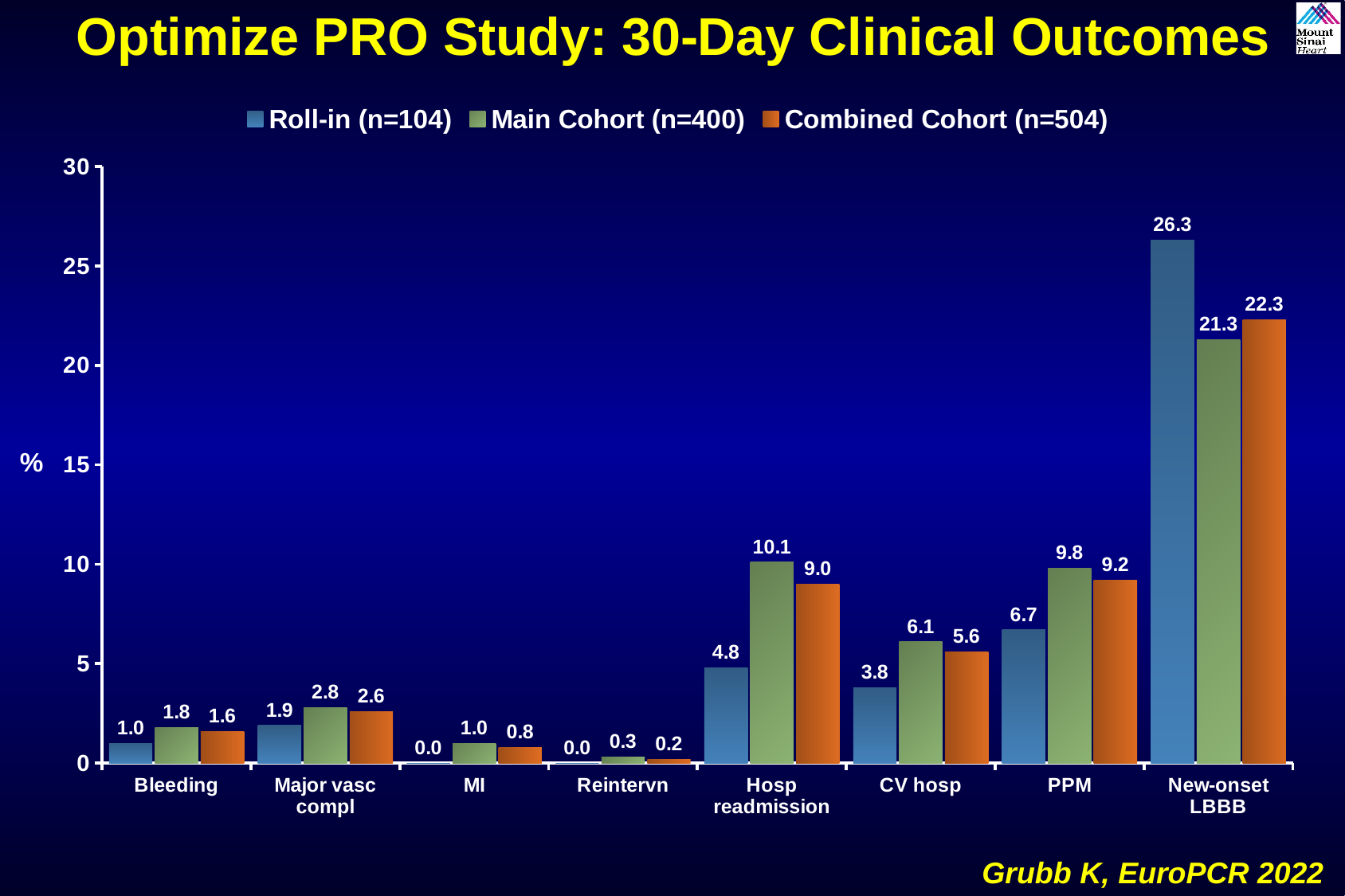
How many series does the legend list? 3 What kind of chart is shown on the slide? Bar chart What is the label on the y axis? % Which category has the lowest Main Cohort (n=400) value? Reintervn For CV hosp, which is larger: the Roll-in (n=104) value or the Main Cohort (n=400) value? Main Cohort (n=400) Which category has the highest Combined Cohort (n=504) value? New-onset LBBB What is the Roll-in (n=104) value for New-onset LBBB? 26.3 What is the difference between the Roll-in (n=104) and Main Cohort (n=400) values for New-onset LBBB? 5.0 How many outcome categories are shown on the x axis? 8 What is the Combined Cohort (n=504) value for PPM? 9.2 What is the Main Cohort (n=400) value for Hosp readmission? 10.1 Is the Main Cohort (n=400) value for PPM greater or less than 5? greater